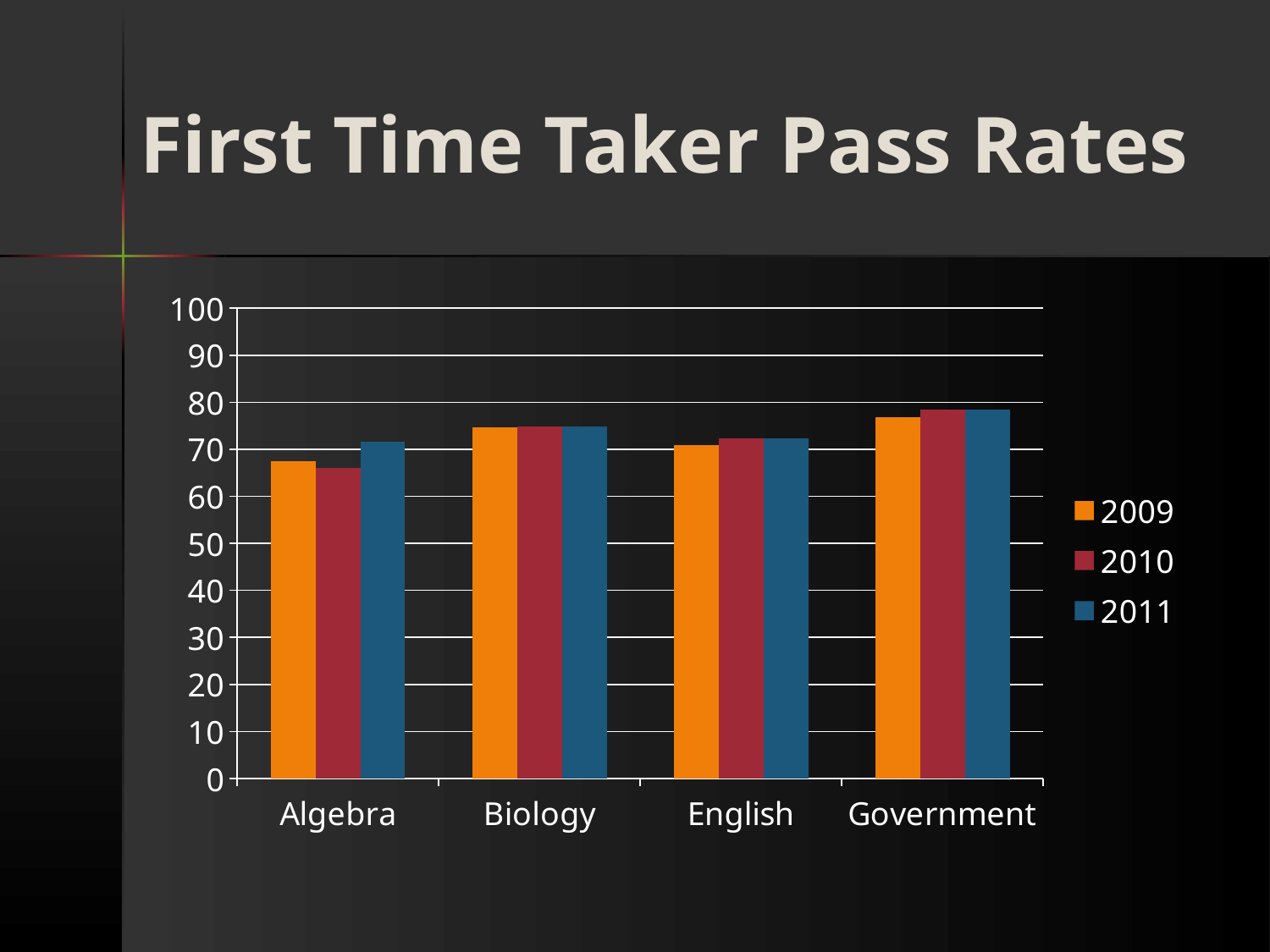
Is the 2009 pass rate for Biology greater or less than 70? greater Is the 2011 pass rate for Government greater or less than 70? greater Is the 2009 pass rate for Government greater or less than 80? less Which subject has the lowest pass rate for 2010? Algebra How many series does the legend list? 3 How many subject categories are shown on the x axis? 4 Which subject has the highest pass rate for 2011? Government Which colour represents the 2009 series in the legend? orange What kind of chart is shown on the slide? bar chart What is the title of the chart? First Time Taker Pass Rates For Algebra, which year has the larger pass rate, 2009 or 2011? 2011